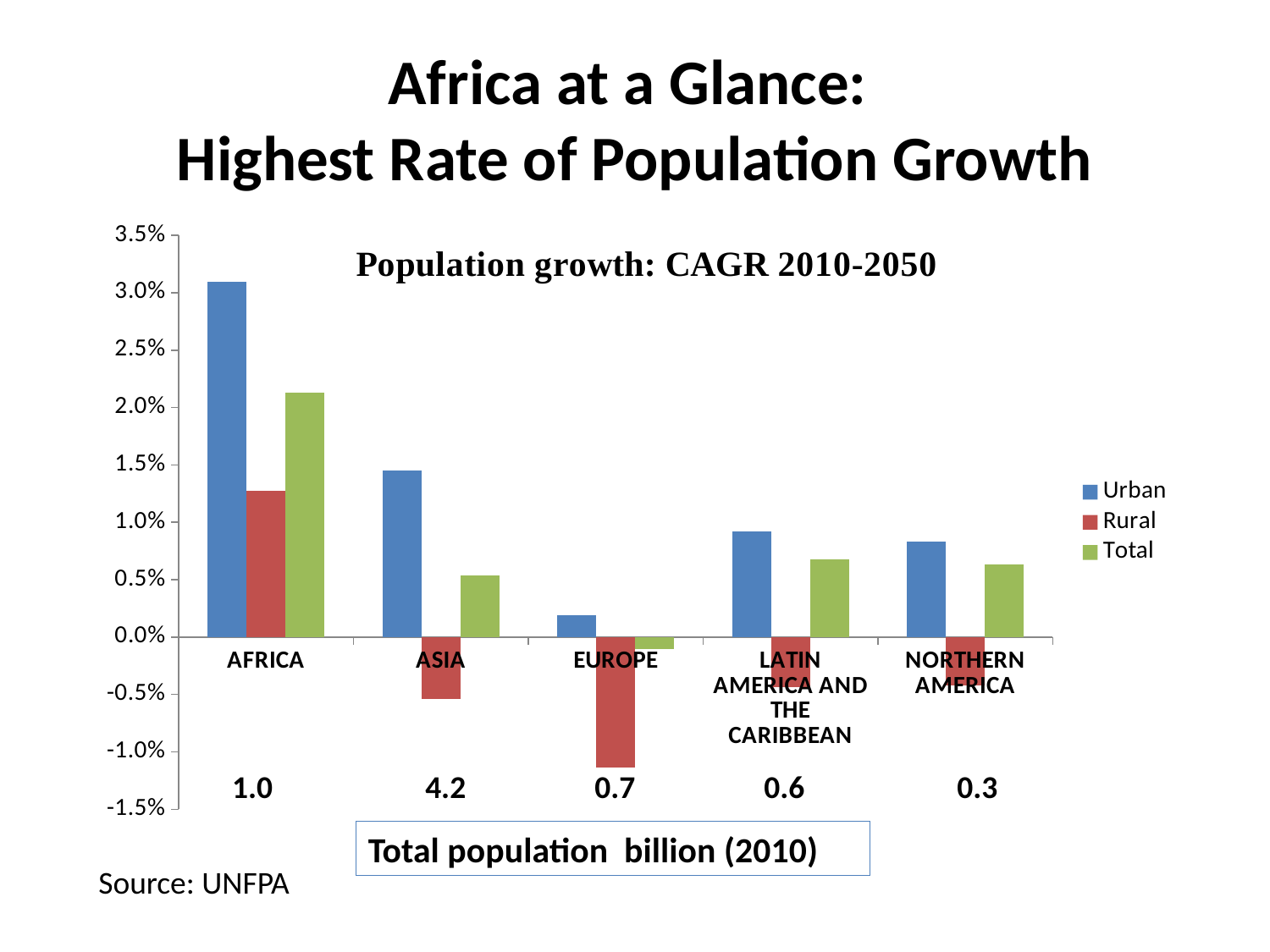
Is the Urban growth rate for EUROPE greater or less than 0.5%? less Which region has the lowest Rural population growth rate in the chart? EUROPE Which region has the highest Urban population growth rate in the chart? AFRICA How many series does the chart's legend list? 3 Which region has the highest Total population growth rate in the chart? AFRICA Which is larger, the Urban growth rate for AFRICA or the Urban growth rate for ASIA? AFRICA What is the title printed inside the chart area? Population growth: CAGR 2010-2050 Is the Urban growth rate for NORTHERN AMERICA greater or less than 0.5%? greater Is the Rural growth rate for EUROPE greater or less than -1.0%? less How many regions (categories) are shown on the x axis of the chart? 5 What kind of chart is shown on the slide? bar chart